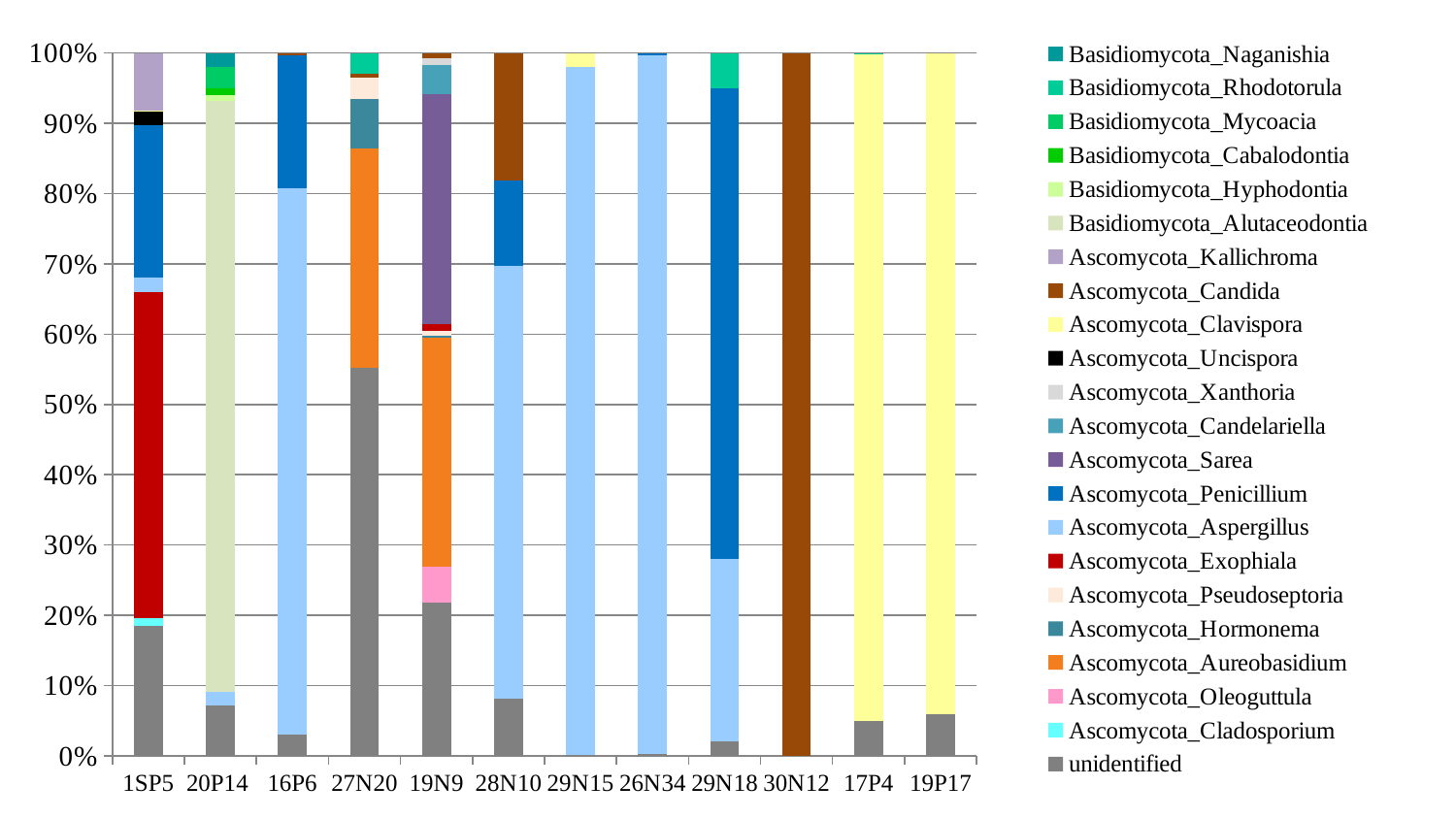
Is the Ascomycota_Aspergillus share for 26N34 greater or less than 90%? greater Which sample is made up entirely of Ascomycota_Candida? 30N12 Is the unidentified share for 27N20 greater or less than 50%? greater How many sample categories are shown along the x axis? 12 Which has the larger unidentified share, 27N20 or 1SP5? 27N20 How many series does the legend list? 22 Which sample has the largest unidentified share? 27N20 Is the Ascomycota_Penicillium share for 29N18 greater or less than 50%? greater Which series is shown in grey at the bottom of the bars? unidentified What kind of chart is shown on the slide? stacked bar chart What is the total of the stacked bar for 1SP5? 100%